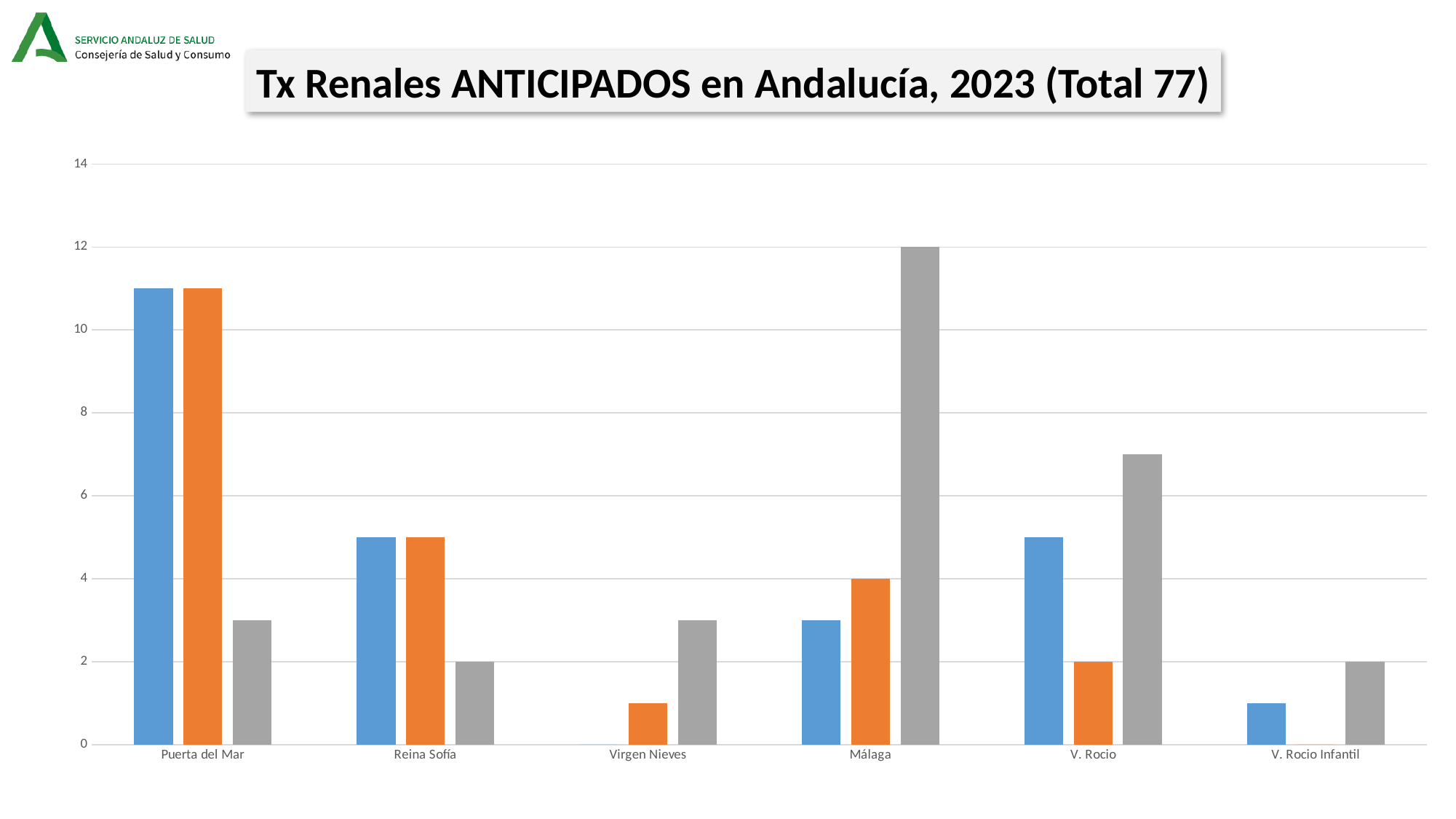
What kind of chart is shown on the slide? bar chart Is the grey bar for V. Rocio greater or less than 6? greater What is the value of the orange bar for V. Rocio? 2 What is the value of the grey bar for Reina Sofía? 2 Which category has the tallest grey bar? Málaga Which is larger for Málaga, the blue bar or the grey bar? grey bar What is the value of the grey bar for V. Rocio Infantil? 2 What is the title of the chart? Tx Renales ANTICIPADOS en Andalucía, 2023 (Total 77) What is the value of the grey bar for Málaga? 12 Is the orange bar for Virgen Nieves greater or less than 2? less How many hospital categories are shown on the x axis? 6 Is the blue bar for Puerta del Mar greater or less than 10? greater